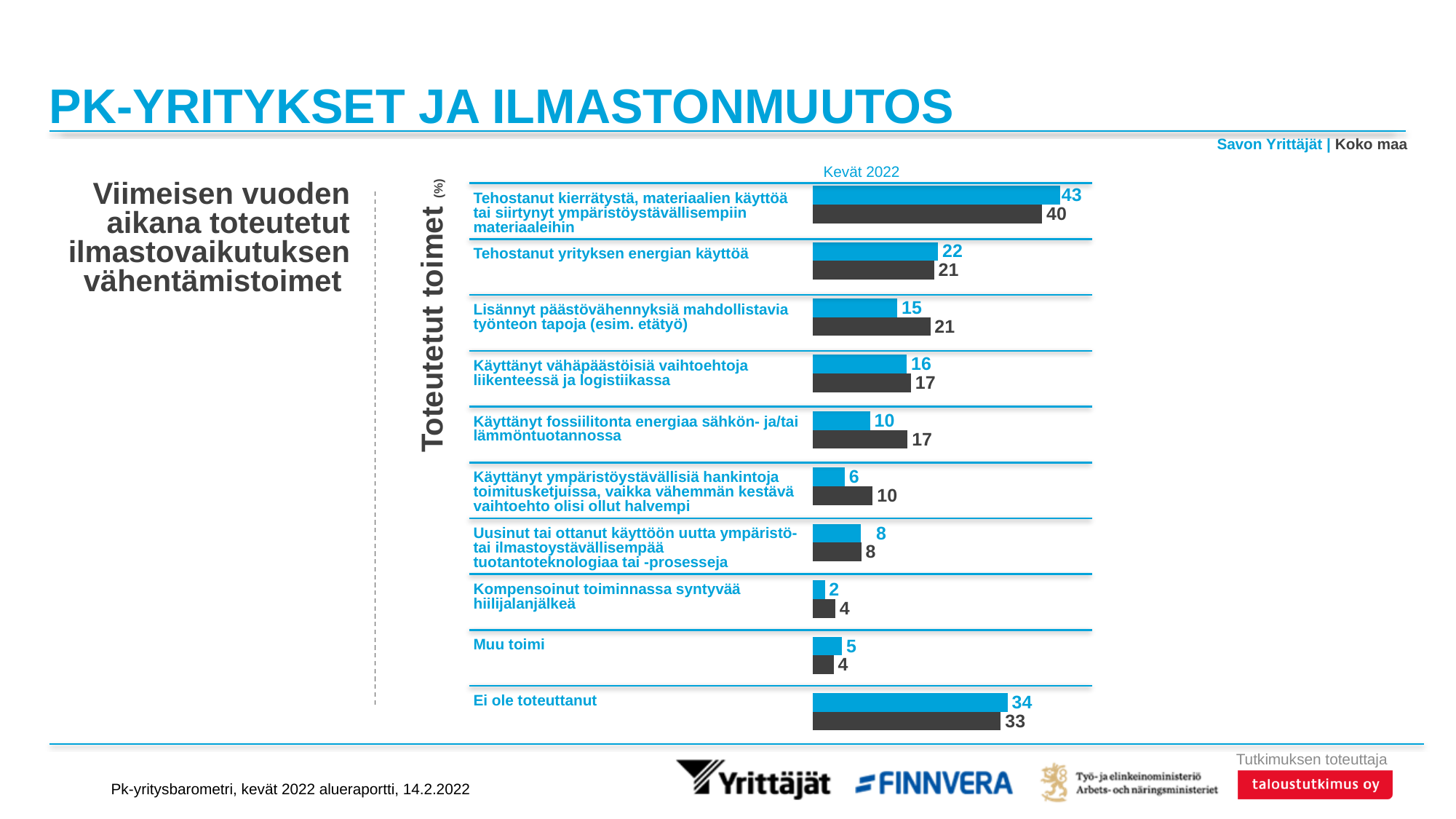
What is the value for Savon Yrittäjät for "Tehostanut yrityksen energian käyttöä"? 22 How many categories are shown in the chart? 10 For "Käyttänyt ympäristöystävällisiä hankintoja toimitusketjuissa, vaikka vähemmän kestävä vaihtoehto olisi ollut halvempi", which is larger: Savon Yrittäjät or Koko maa? Koko maa What is the difference between the Koko maa and Savon Yrittäjät values for "Käyttänyt fossiilitonta energiaa sähkön- ja/tai lämmöntuotannossa"? 7 Which category has the lowest value for Savon Yrittäjät? Kompensoinut toiminnassa syntyvää hiilijalanjälkeä What is the value for Koko maa for "Uusinut tai ottanut käyttöön uutta ympäristö- tai ilmastoystävällisempää tuotantoteknologiaa tai -prosesseja"? 8 Which category has the highest value for Savon Yrittäjät? Tehostanut kierrätystä, materiaalien käyttöä tai siirtynyt ympäristöystävällisempiin materiaaleihin What is the value for Savon Yrittäjät for "Ei ole toteuttanut"? 34 What is the value for Koko maa for "Lisännyt päästövähennyksiä mahdollistavia työnteon tapoja (esim. etätyö)"? 21 What kind of chart is shown on the slide? Bar chart For "Muu toimi", which is larger: the Savon Yrittäjät value or the Koko maa value? Savon Yrittäjät How many series does the chart show? 2